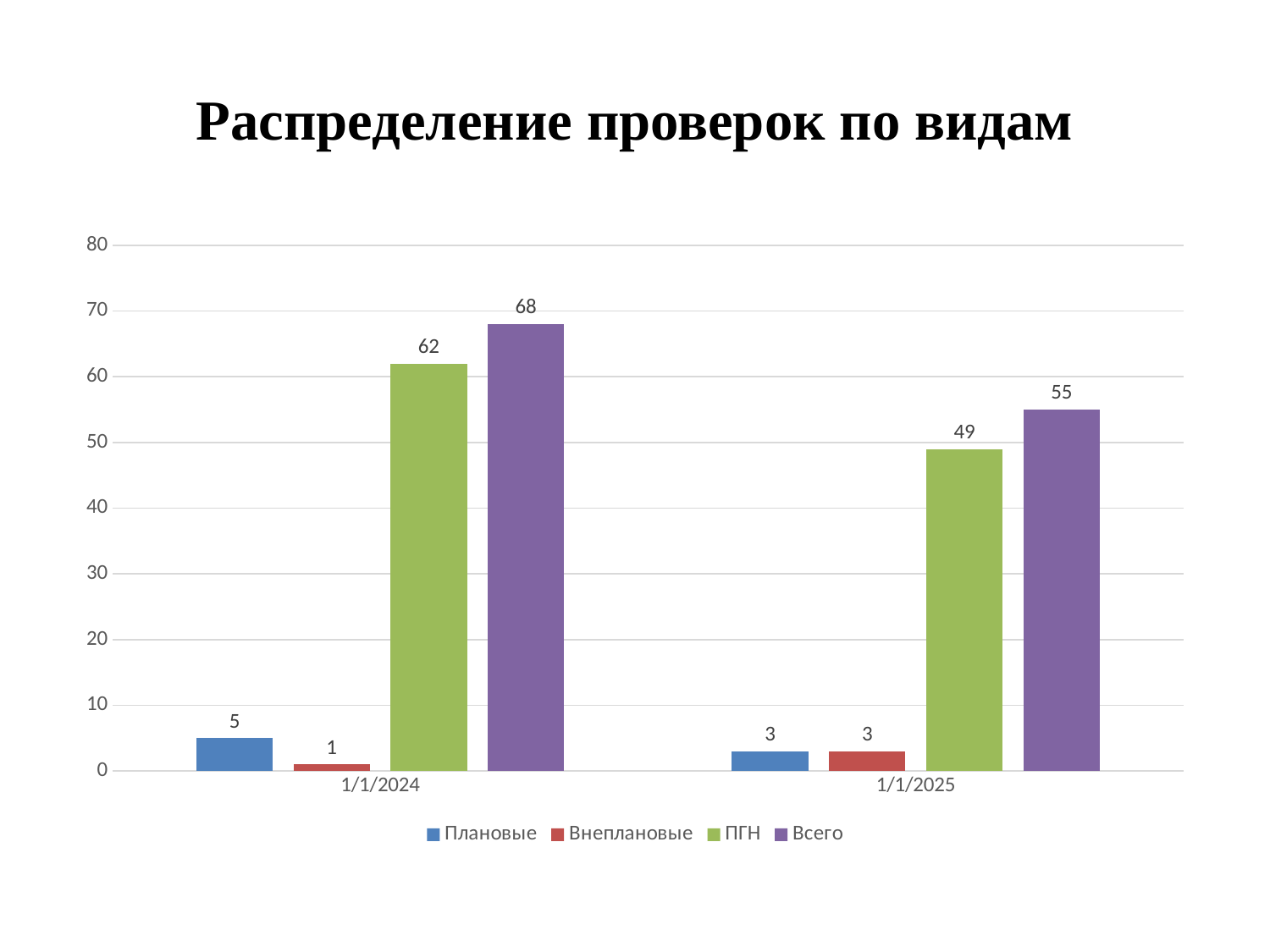
What is the value of Всего for 1/1/2024? 68 What kind of chart is shown on the slide? Bar chart Which series has the lowest value for 1/1/2024? Внеплановые What is the difference between Всего for 1/1/2024 and Всего for 1/1/2025? 13 What is the value of Внеплановые for 1/1/2025? 3 How many categories are shown on the x axis? 2 What is the value of ПГН for 1/1/2025? 49 What is the value of Плановые for 1/1/2024? 5 What is the title of the chart? Распределение проверок по видам How many series does the legend list? 4 Which is larger: ПГН for 1/1/2024 or ПГН for 1/1/2025? ПГН for 1/1/2024 Which series has the highest value for 1/1/2025? Всего